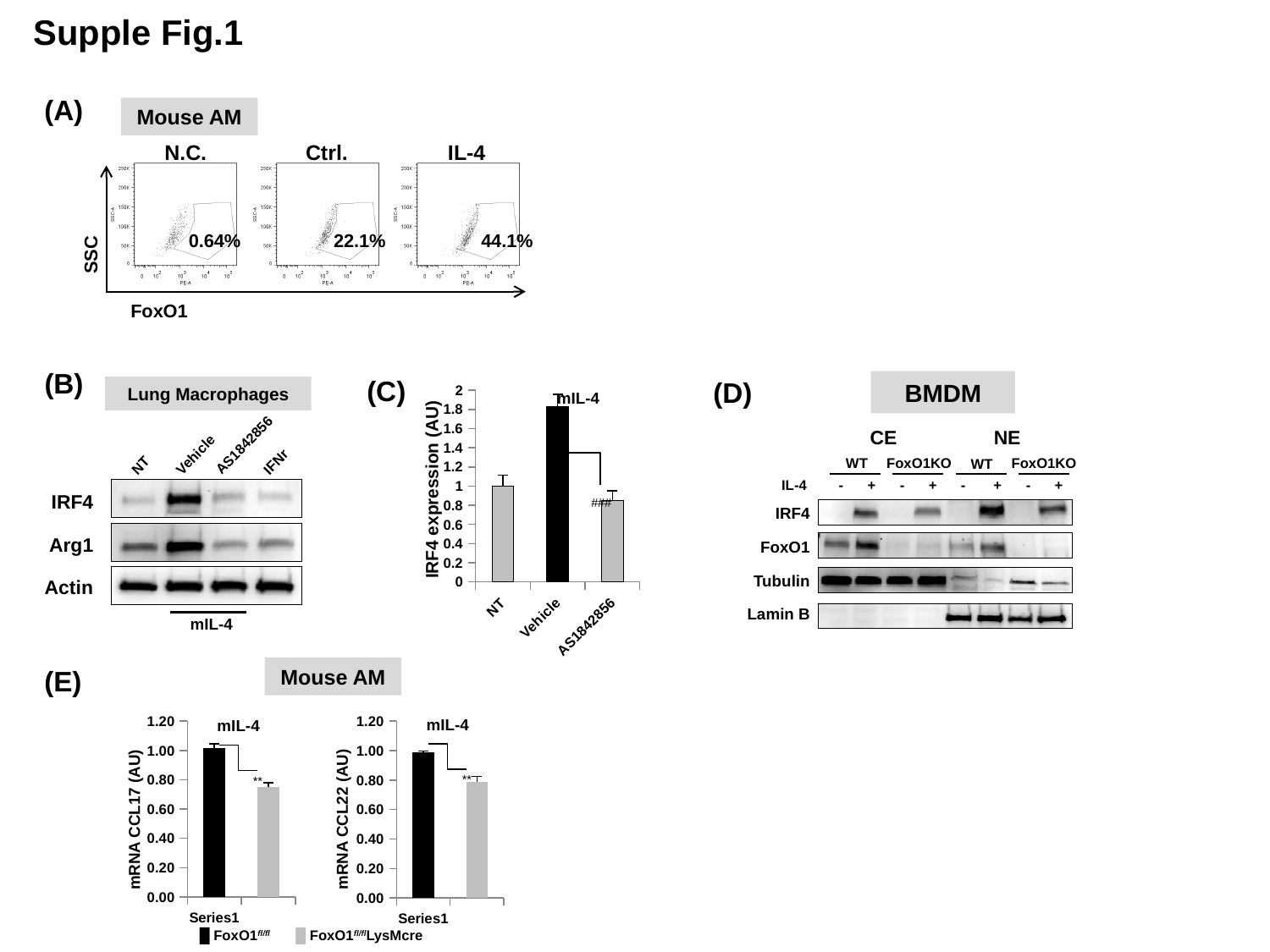
In panel (C), the IRF4 expression chart, how many categories are shown on the x axis? 3 In panel (C), the IRF4 expression chart, which category has the lowest bar? AS1842856 In panel (A), what percentage is printed in the IL-4 flow cytometry plot? 44.1% In panel (E), the mRNA CCL17 chart, is the value for FoxO1fl/flLysMcre greater or less than 1.00? less In panel (E), the mRNA CCL17 chart, which series has the larger bar, FoxO1fl/fl or FoxO1fl/flLysMcre? FoxO1fl/fl In panel (C), the IRF4 expression chart, which category has the highest bar? Vehicle In panel (E), how many series does the legend list? 2 In panel (E), the mRNA CCL22 chart, is the value for FoxO1fl/flLysMcre greater or less than 1.00? less In panel (A), what percentage is printed in the Ctrl. flow cytometry plot? 22.1% In panel (C), is the IRF4 expression value for AS1842856 greater or less than 1? less What kind of chart is shown in panel (C)? bar chart